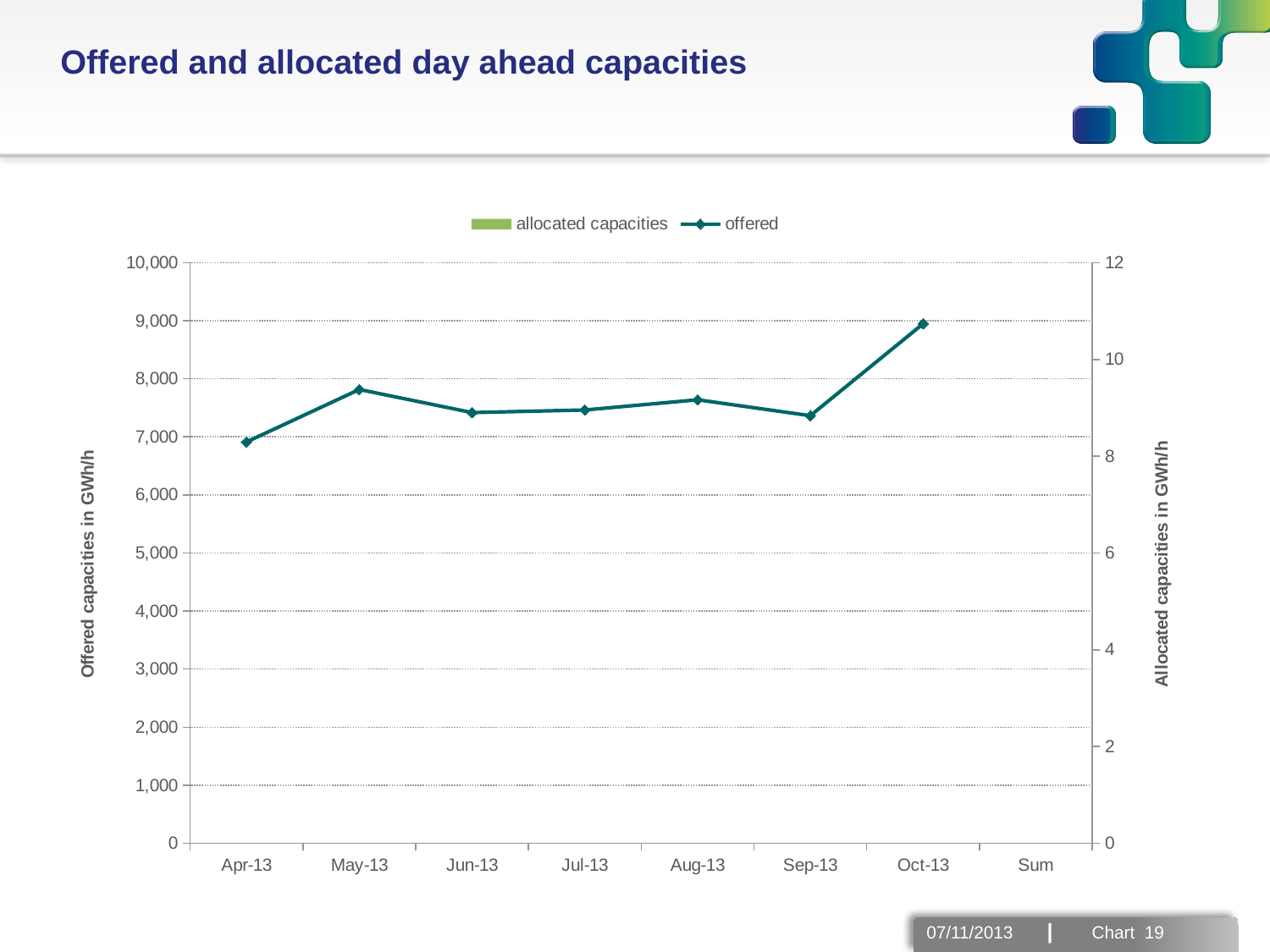
How many series does the legend list? 2 What is the title of the slide? Offered and allocated day ahead capacities Which month has the lowest offered value? Apr-13 Is the offered value for Oct-13 greater or less than 8,000? greater Is the offered value for May-13 greater or less than 7,000? greater Which month has the highest offered value? Oct-13 What is the label of the right-hand vertical axis? Allocated capacities in GWh/h What kind of chart is shown on the slide? line chart Does the offered line rise or fall from Sep-13 to Oct-13? rise Which is larger, the offered value for May-13 or for Jun-13? May-13 How many data points are plotted on the offered line? 7